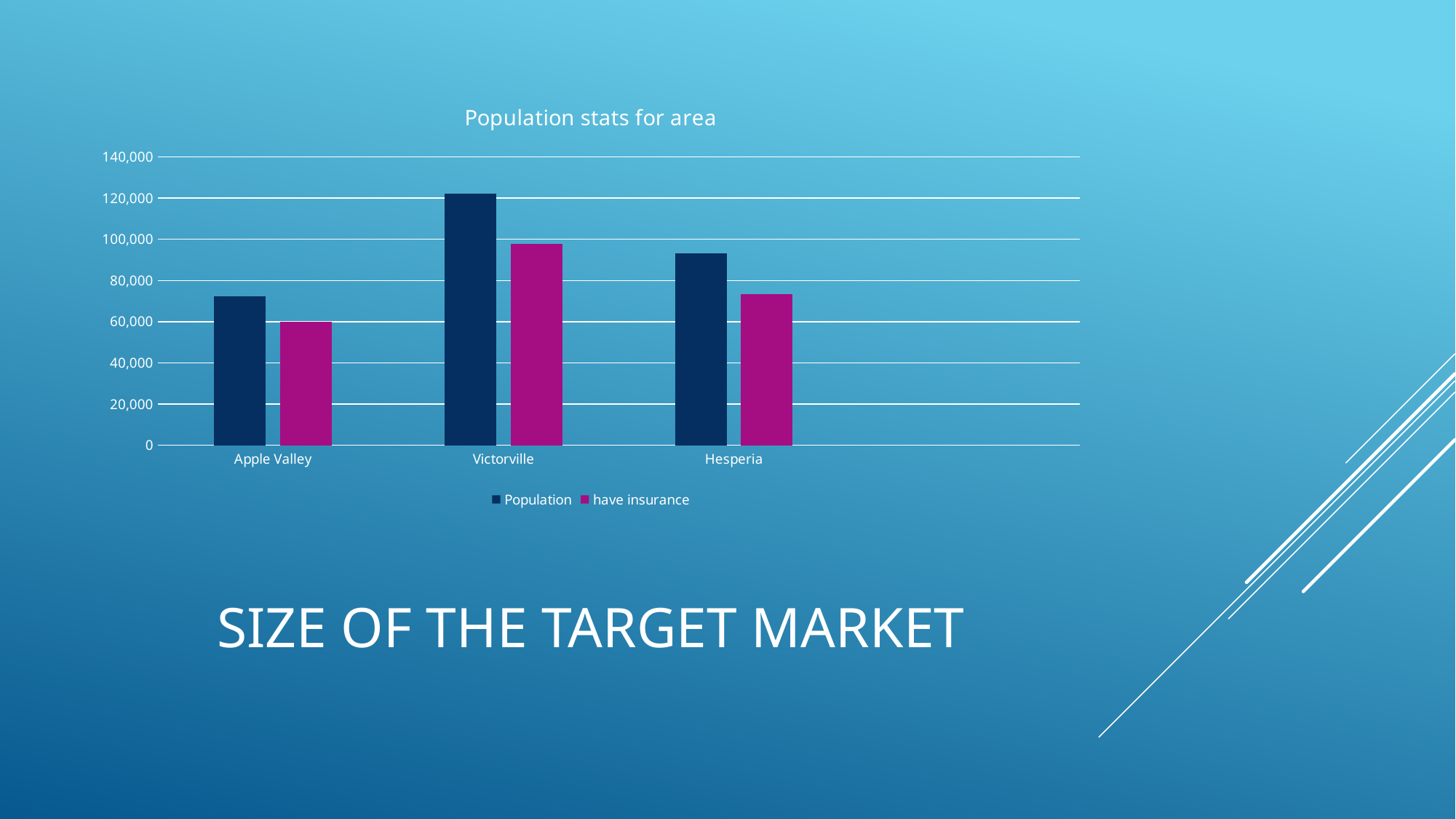
Is the 'have insurance' value for Victorville greater or less than 80,000? greater Is the Population value for Apple Valley greater or less than 80,000? less Which area has the lowest 'have insurance' bar? Apple Valley Which is larger, the Population for Victorville or the Population for Hesperia? Victorville What is the title of the chart? Population stats for area Which series is shown in magenta in the legend? have insurance Which area has the highest Population bar? Victorville How many series does the legend list? 2 How many areas are shown on the x axis? 3 Is the Population value for Victorville greater or less than 100,000? greater What kind of chart is shown on the slide? bar chart